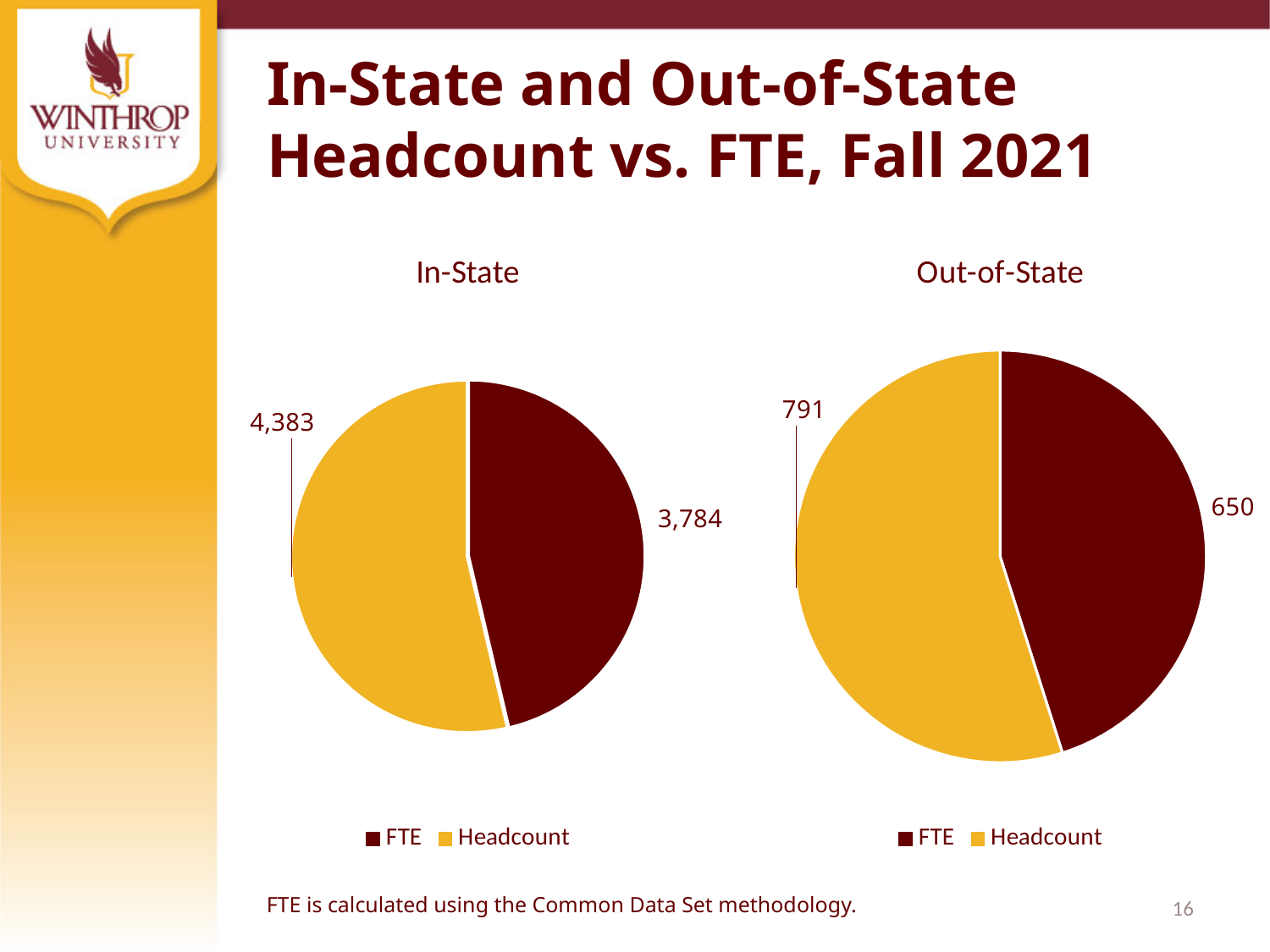
In the Out-of-State chart, what is the difference between Headcount and FTE? 141 How many slices does the In-State chart have? 2 In the Out-of-State chart, what is the Headcount value? 791 In the In-State chart, what is the FTE value? 3,784 In the In-State chart, which slice is larger, FTE or Headcount? Headcount In the In-State chart, what is the Headcount value? 4,383 What type of chart is the Out-of-State chart? Pie chart How many series does the legend of the Out-of-State chart list? 2 In the In-State chart, what colour is the FTE slice? Dark red In the Out-of-State chart, what is the FTE value? 650 In the In-State chart, what is the difference between Headcount and FTE? 599 In the Out-of-State chart, which slice is the smallest? FTE